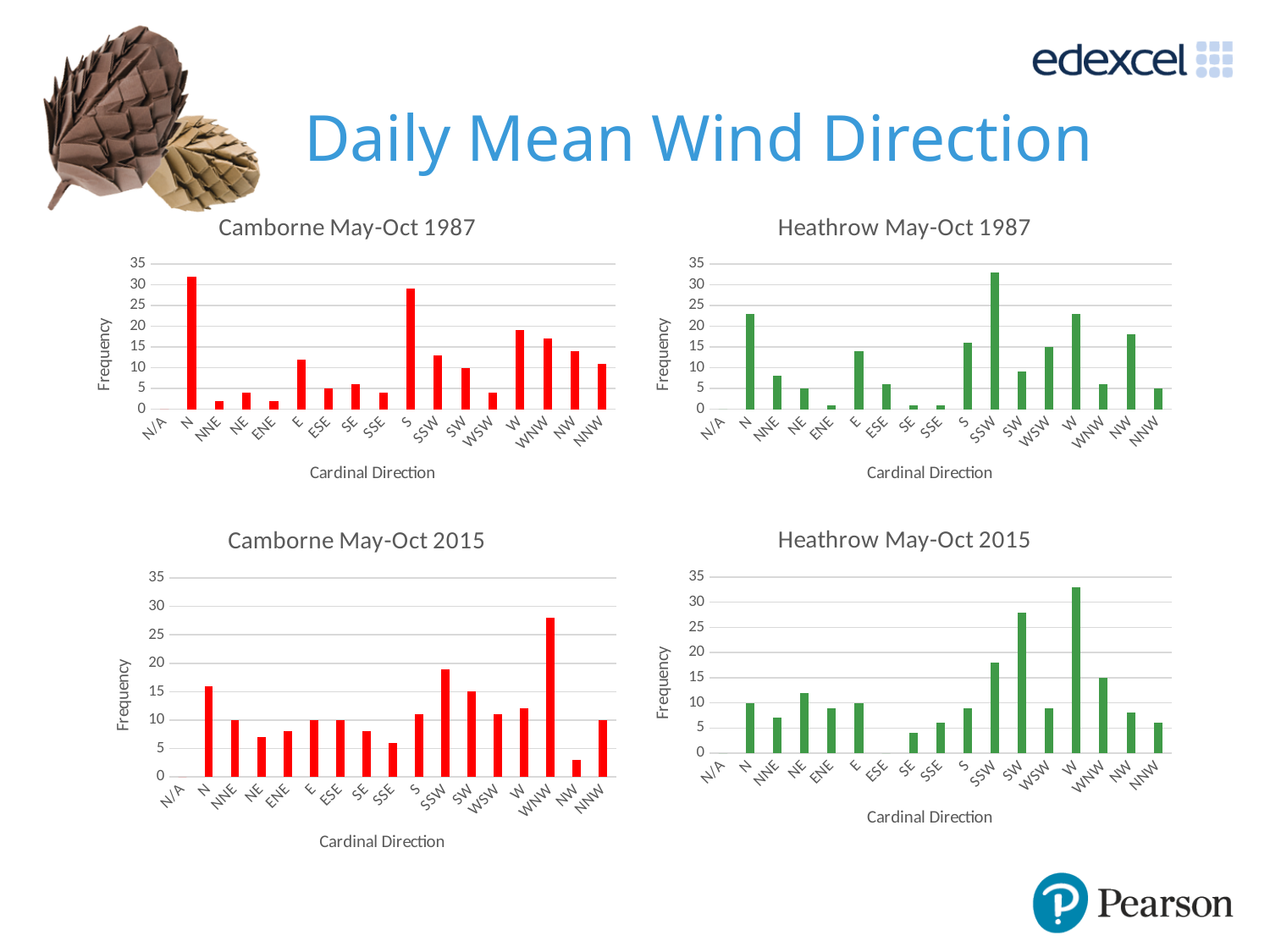
How many cardinal direction categories are shown on the x axis of the Heathrow May-Oct 2015 chart? 17 In the Heathrow May-Oct 2015 chart, which cardinal direction has the highest frequency? W In the Heathrow May-Oct 1987 chart, is the frequency for W greater or less than 20? greater In the Heathrow May-Oct 1987 chart, which cardinal direction has the highest frequency? SSW In the Camborne May-Oct 2015 chart, which cardinal direction has the highest frequency? WNW What colour are the bars in the Heathrow May-Oct 1987 chart? green In the Camborne May-Oct 1987 chart, is the frequency for N greater or less than 30? greater What kind of chart is the Camborne May-Oct 1987 chart? bar chart In the Heathrow May-Oct 2015 chart, is the frequency for SW greater or less than 25? greater In the Camborne May-Oct 1987 chart, which has the higher frequency, N or S? N In the Camborne May-Oct 2015 chart, which has the higher frequency, SSW or WNW? WNW